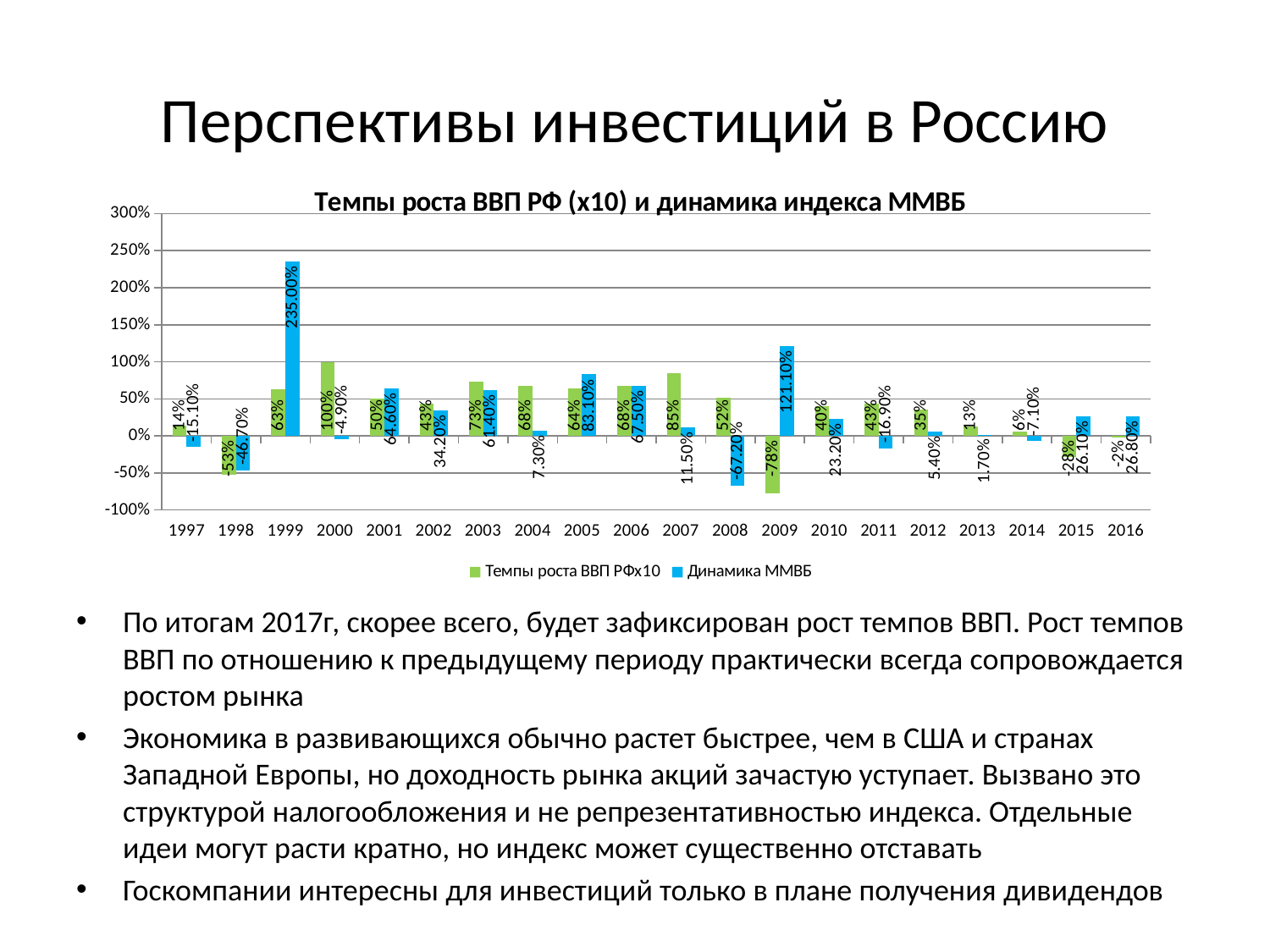
What is the title of the chart? Темпы роста ВВП РФ (x10) и динамика индекса ММВБ What is the value of Темпы роста ВВП РФх10 for 2000? 100% Which is larger in 2005: Темпы роста ВВП РФх10 or Динамика ММВБ? Динамика ММВБ How many series does the legend list? 2 In which year is Темпы роста ВВП РФх10 lowest? 2009 In which year is Динамика ММВБ highest? 1999 What is the value of Темпы роста ВВП РФх10 for 2009? -78% What is the difference between Динамика ММВБ in 1999 and in 2009? 113.90% What type of chart is shown on the slide? bar chart What is the value of Динамика ММВБ for 1999? 235.00% What is the value of Динамика ММВБ for 2009? 121.10% How many years are shown on the x axis? 20